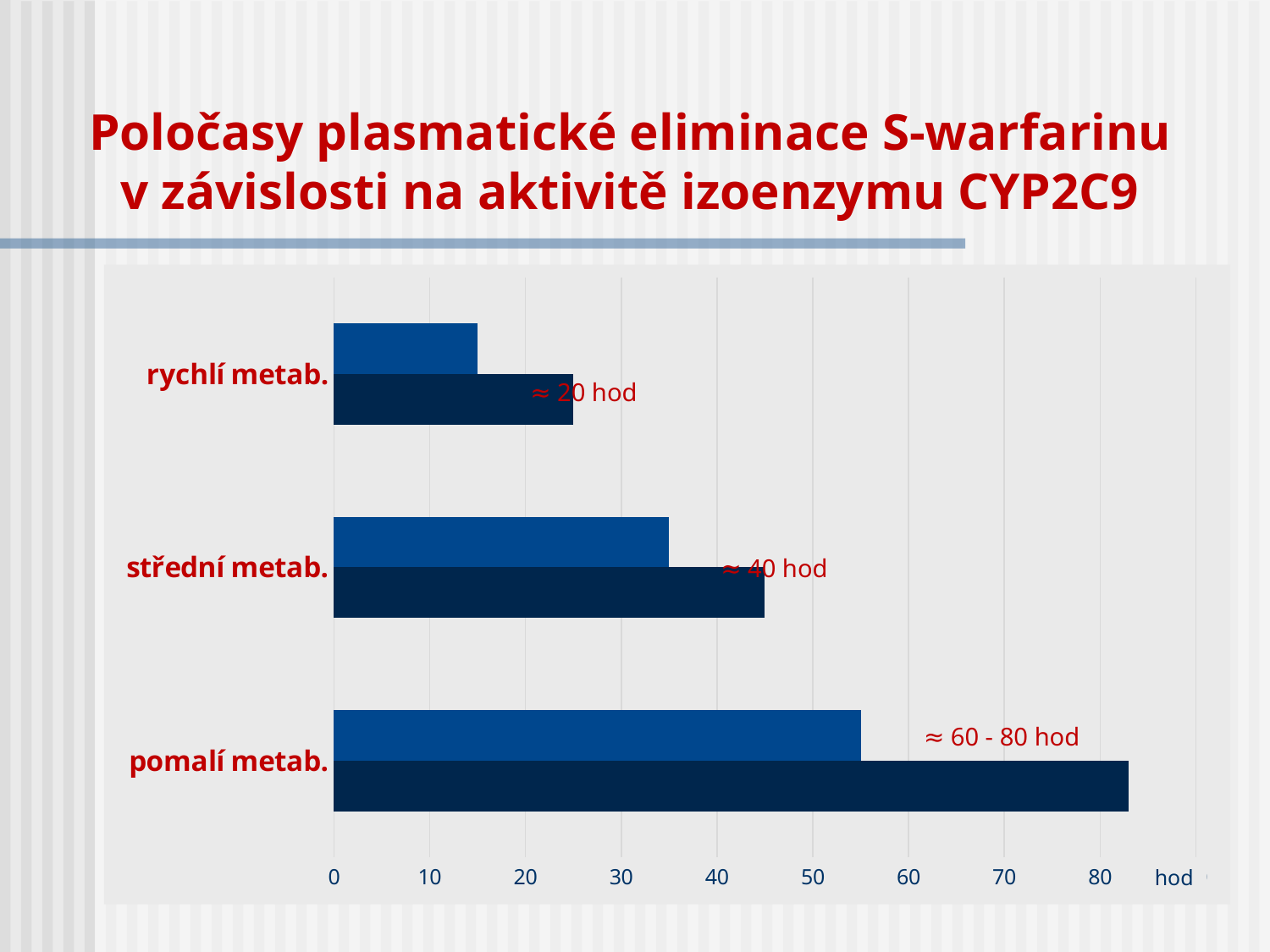
Which category has the longest bars on the chart? pomalí metab. What kind of chart is shown on the slide? bar chart What approximate value is annotated next to the bars for pomalí metab.? ≈ 60 - 80 hod Is the longer (dark blue) bar for střední metab. greater or less than 40? greater How many categories are shown on the chart? 3 Is the shorter (light blue) bar for rychlí metab. greater or less than 20? less Is the shorter (light blue) bar for pomalí metab. greater or less than 50? greater Which is larger: the dark blue bar for střední metab. or the dark blue bar for rychlí metab.? střední metab. What unit is written at the end of the horizontal axis? hod Which category has the shortest bars on the chart? rychlí metab.